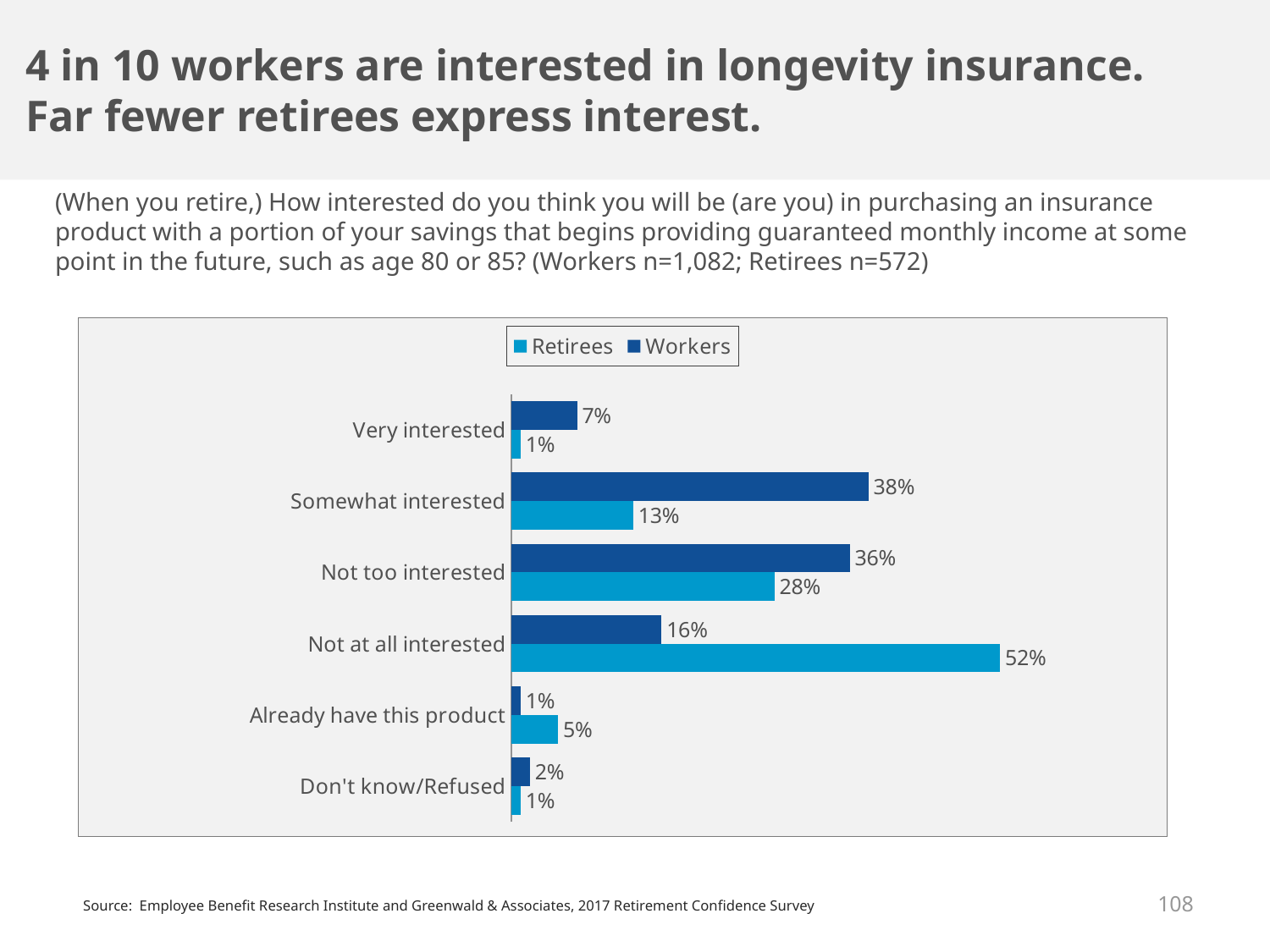
For Already have this product, which series has the larger value, Retirees or Workers? Retirees What kind of chart is shown on the slide? Bar chart How many response categories are shown on the chart? 6 What percentage of Workers are Somewhat interested? 38% What is the difference between the Retirees and Workers values for Not at all interested? 36% How many series does the legend list? 2 What percentage of Workers are Very interested? 7% Which category has the highest value for Retirees? Not at all interested What is the difference between the Workers and Retirees values for Somewhat interested? 25% What percentage of Retirees are Not too interested? 28% What percentage of Retirees are Not at all interested? 52% Which category has the highest value for Workers? Somewhat interested